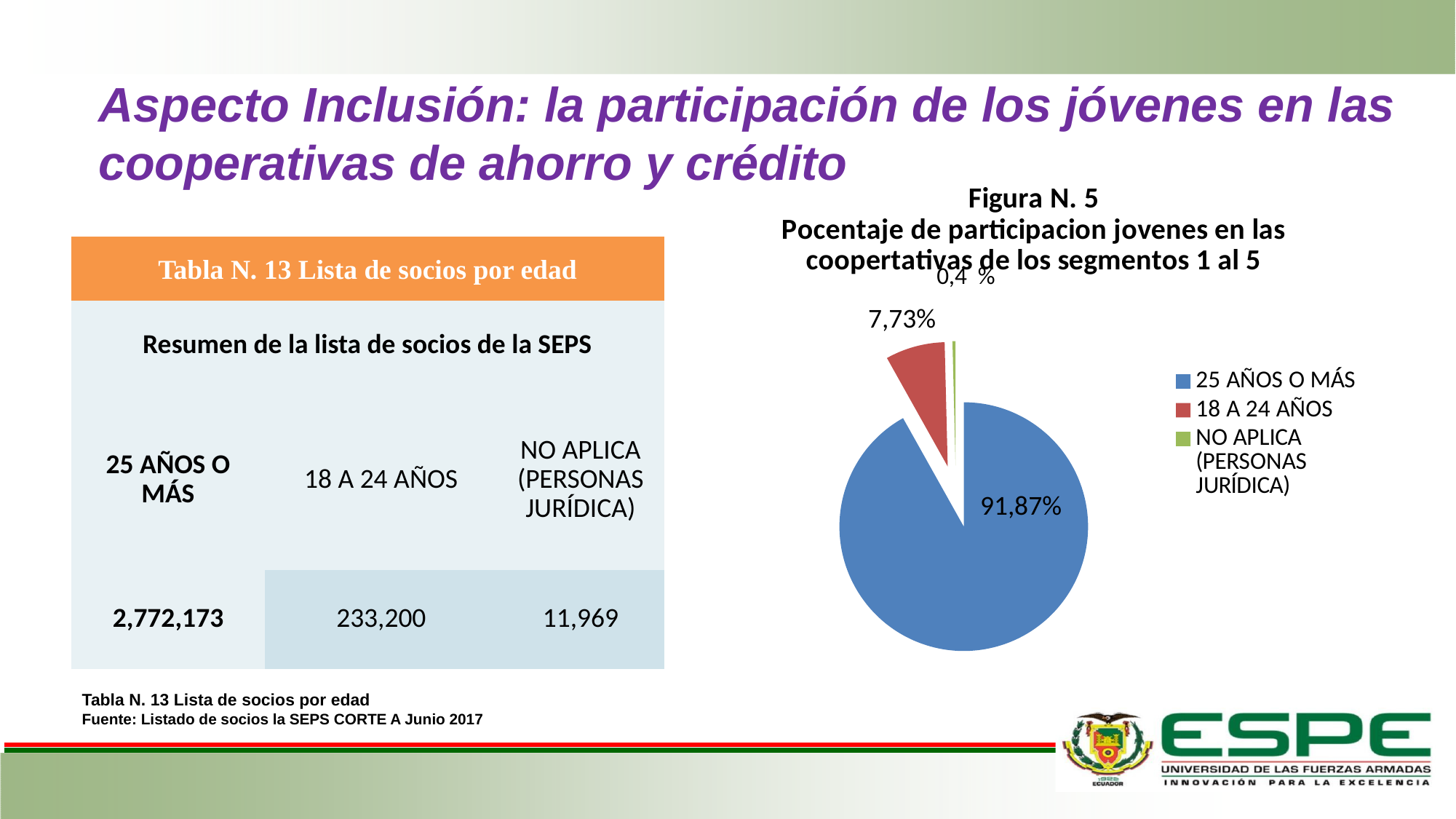
What percentage does the pie chart show for 18 A 24 AÑOS? 7,73% How many slices does the pie chart have? 3 What is the difference in percentage points between the 25 AÑOS O MÁS slice and the 18 A 24 AÑOS slice? 84,14 How many entries does the legend of the pie chart list? 3 Which category has the largest slice in the pie chart? 25 AÑOS O MÁS What type of chart is shown in Figura N. 5? pie chart What is the figure number given in the title of the pie chart? Figura N. 5 What percentage does the pie chart show for NO APLICA (PERSONAS JURÍDICA)? 0,4 % Which slice is larger in the pie chart: 18 A 24 AÑOS or NO APLICA (PERSONAS JURÍDICA)? 18 A 24 AÑOS What percentage does the pie chart show for 25 AÑOS O MÁS? 91,87% Which category has the smallest slice in the pie chart? NO APLICA (PERSONAS JURÍDICA) What colour is the 18 A 24 AÑOS slice in the pie chart? red